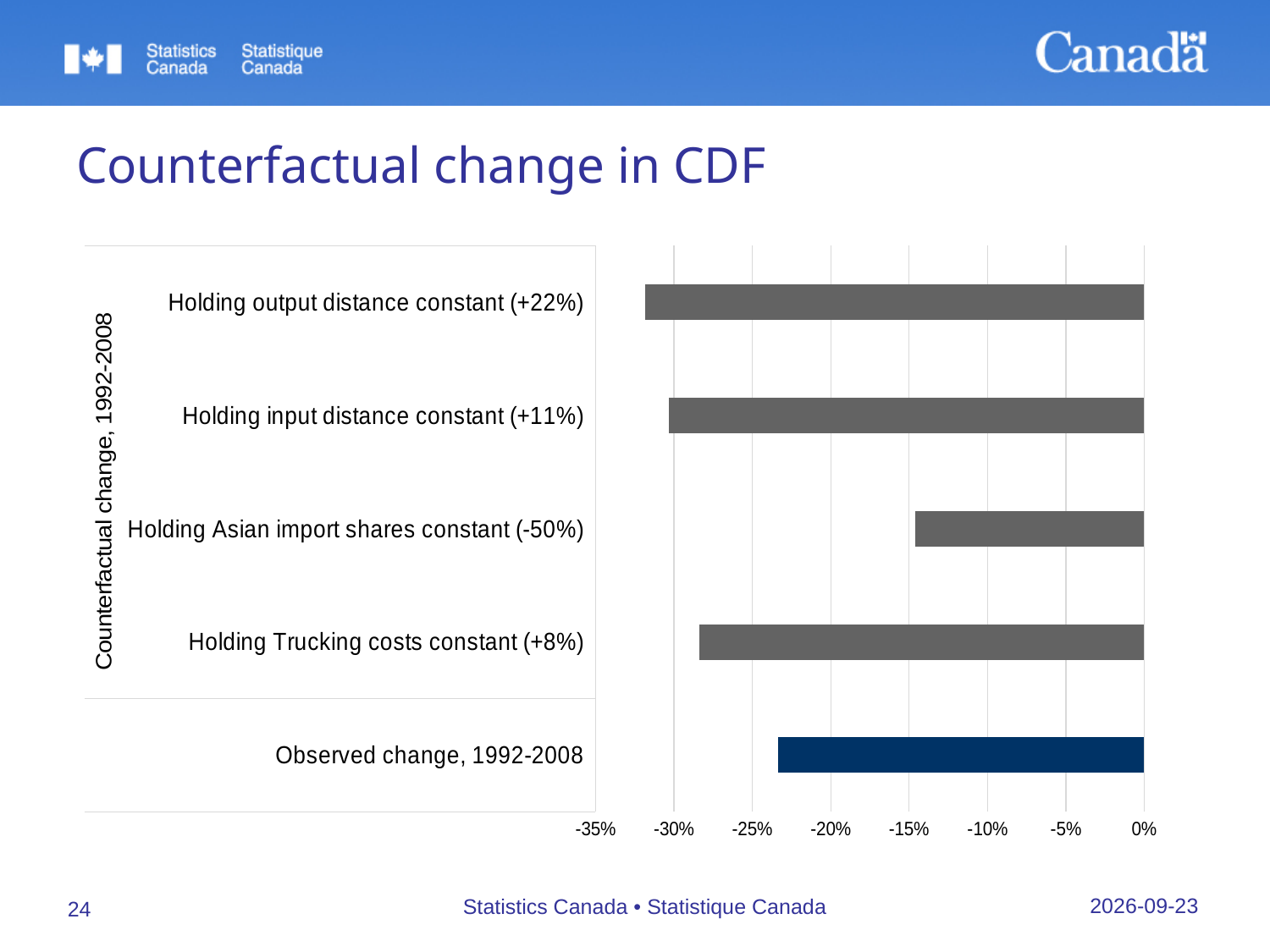
What kind of chart is shown on the slide? bar chart Which is more negative: 'Holding Trucking costs constant (+8%)' or 'Observed change, 1992-2008'? Holding Trucking costs constant (+8%) Is the value for 'Holding Trucking costs constant (+8%)' greater or less than -30%? greater What is the title of the slide containing the chart? Counterfactual change in CDF How many bars (categories) does the chart show? 5 Is the value for 'Holding output distance constant (+22%)' greater or less than -30%? less Is the value for 'Observed change, 1992-2008' greater or less than -25%? greater Which bar is shown in a different colour (dark blue) from the others? Observed change, 1992-2008 Which category has the least negative (highest) value? Holding Asian import shares constant (-50%) Which category has the most negative (lowest) value? Holding output distance constant (+22%)